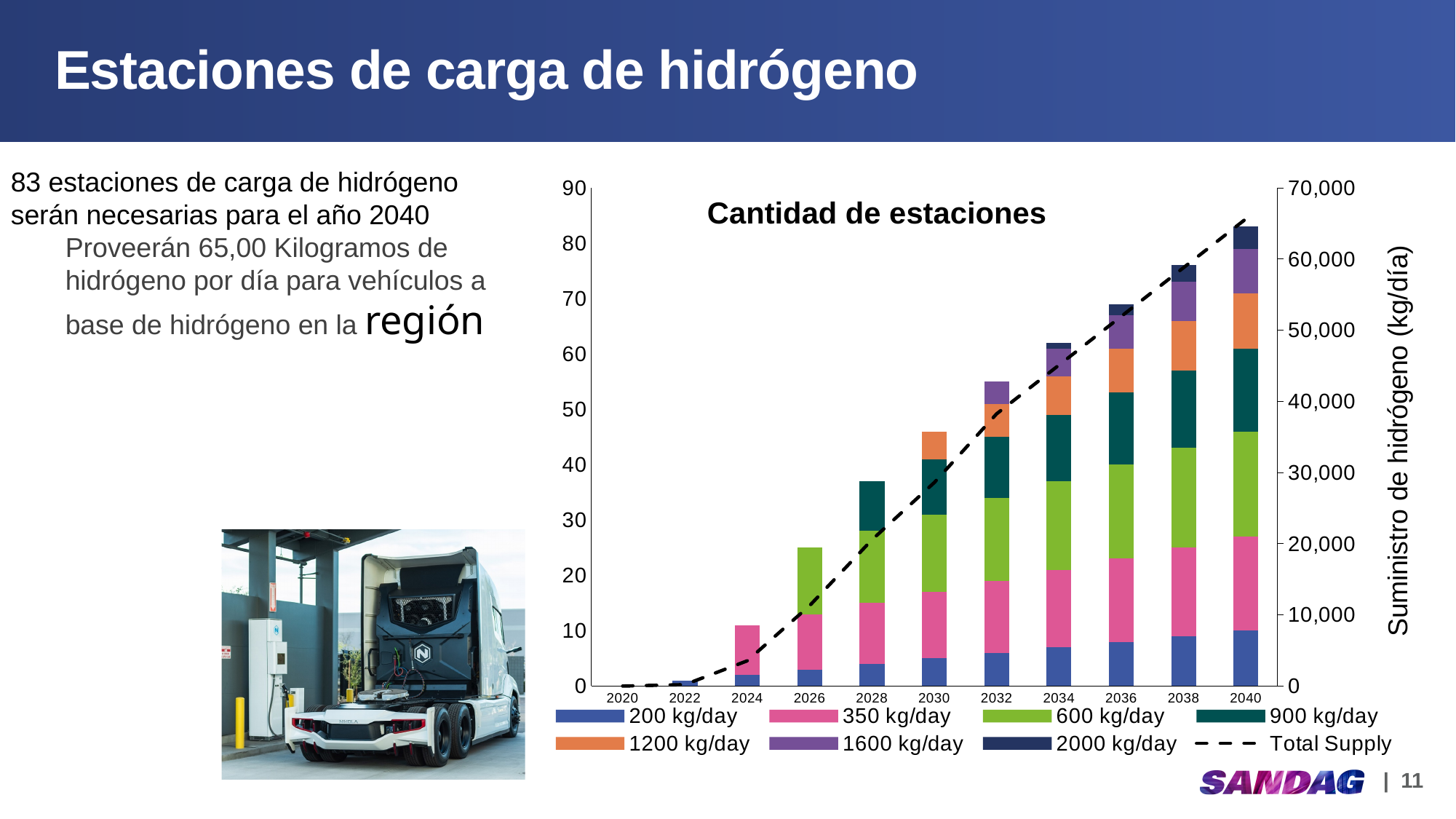
Is the Total Supply value for 2040 greater or less than 60,000 kg/day? greater Is the total height of the stacked bar for 2040 greater or less than 80? greater What kind of chart is shown on the slide? Stacked bar chart with a line How many years are shown along the x axis of the chart? 11 What is the title of the chart? Cantidad de estaciones Which year has the smallest stacked bar in the chart? 2020 Which year has the tallest stacked bar in the chart? 2040 Which year has a taller stacked bar, 2036 or 2038? 2038 Is the total height of the stacked bar for 2026 greater or less than 30? less Do the stacked bars rise or fall from 2020 to 2040? rise How many entries does the chart legend list? 8